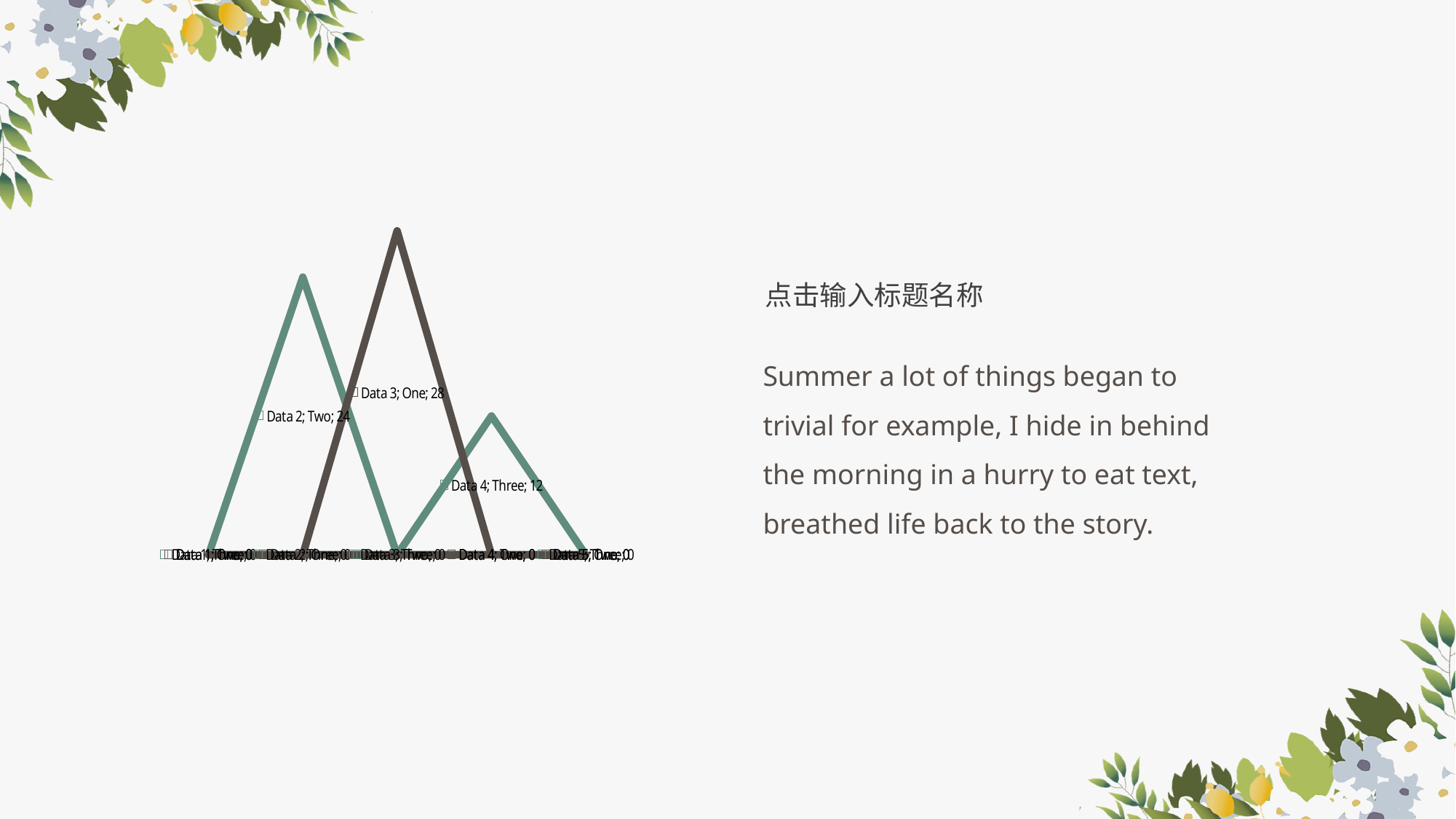
What is the value of series One at Data 3? 28 What is the value of series Three at Data 4? 12 What is the difference between the peak of series One (28) and the peak of series Two (24)? 4 What kind of chart is shown on the slide? line chart At which category does series One reach its peak? Data 3 How many categories are plotted along the x axis? 5 What is the difference between the peak of series Two (24) and the peak of series Three (12)? 12 What is the value of series Two at Data 2? 24 Which series reaches the highest peak value? One Which series has the lowest peak value? Three What is the difference between the peak of series One (28) and the peak of series Three (12)? 16 Which is larger: the value of series One at Data 3 or the value of series Two at Data 2? series One at Data 3